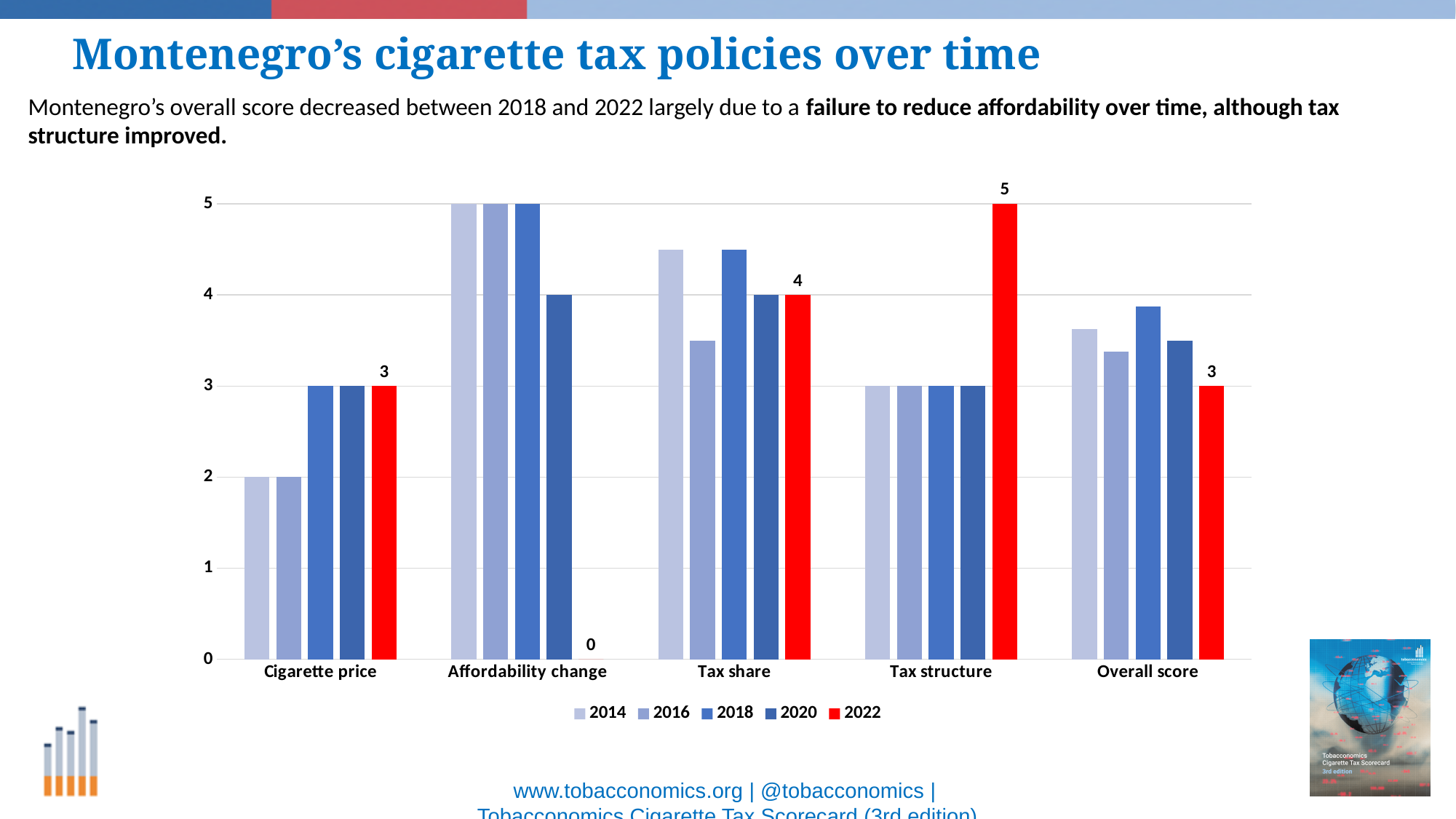
Do the values for Affordability change rise or fall from 2014 to 2022? fall What is the difference between the 2022 values for Tax structure and Overall score? 2 What is the value for Affordability change in 2020? 4 What is the value for Tax structure in 2022? 5 Which category has the highest value in 2022? Tax structure What is the value for Tax share in 2022? 4 How many categories are shown on the x axis? 5 Which is larger in 2022: Tax share or Cigarette price? Tax share How many series does the legend list? 5 Is the value for Overall score in 2018 greater or less than 3? greater Which category has the lowest value in 2022? Affordability change What is the value for Affordability change in 2022? 0